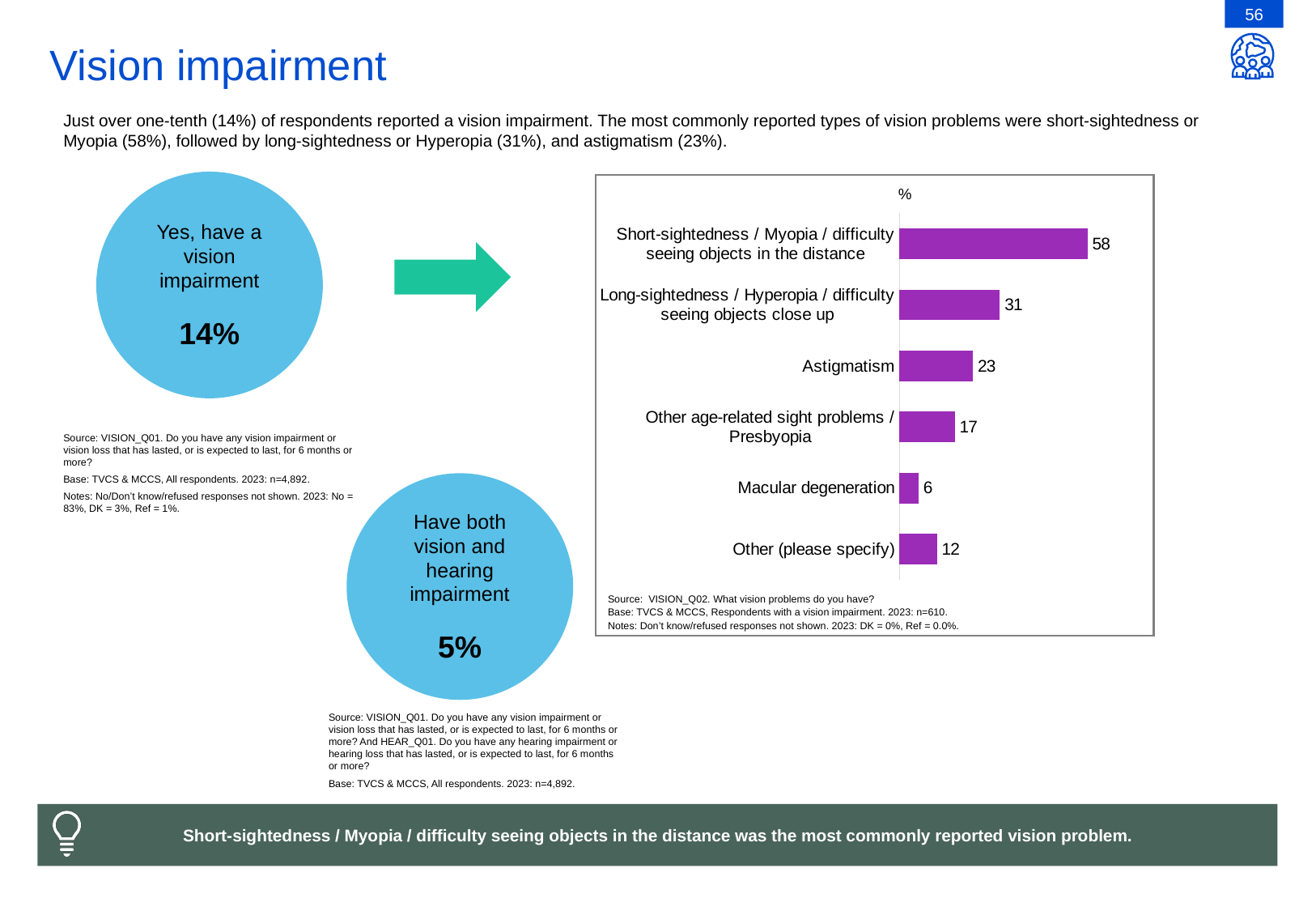
What is the difference between the values for Short-sightedness / Myopia and Long-sightedness / Hyperopia in the bar chart? 27 Which is larger in the bar chart: Astigmatism or Other (please specify)? Astigmatism What is the difference between the values for Other (please specify) and Macular degeneration in the bar chart? 6 What colour are the bars in the bar chart? Purple What is the value for Astigmatism in the bar chart? 23 What is the value for Long-sightedness / Hyperopia / difficulty seeing objects close up in the bar chart? 31 Which category has the highest value in the bar chart? Short-sightedness / Myopia / difficulty seeing objects in the distance How many categories are shown in the bar chart? 6 What is the value for Macular degeneration in the bar chart? 6 Which category has the lowest value in the bar chart? Macular degeneration What kind of chart is used to show the types of vision problems? Bar chart What is the value for Other age-related sight problems / Presbyopia in the bar chart? 17